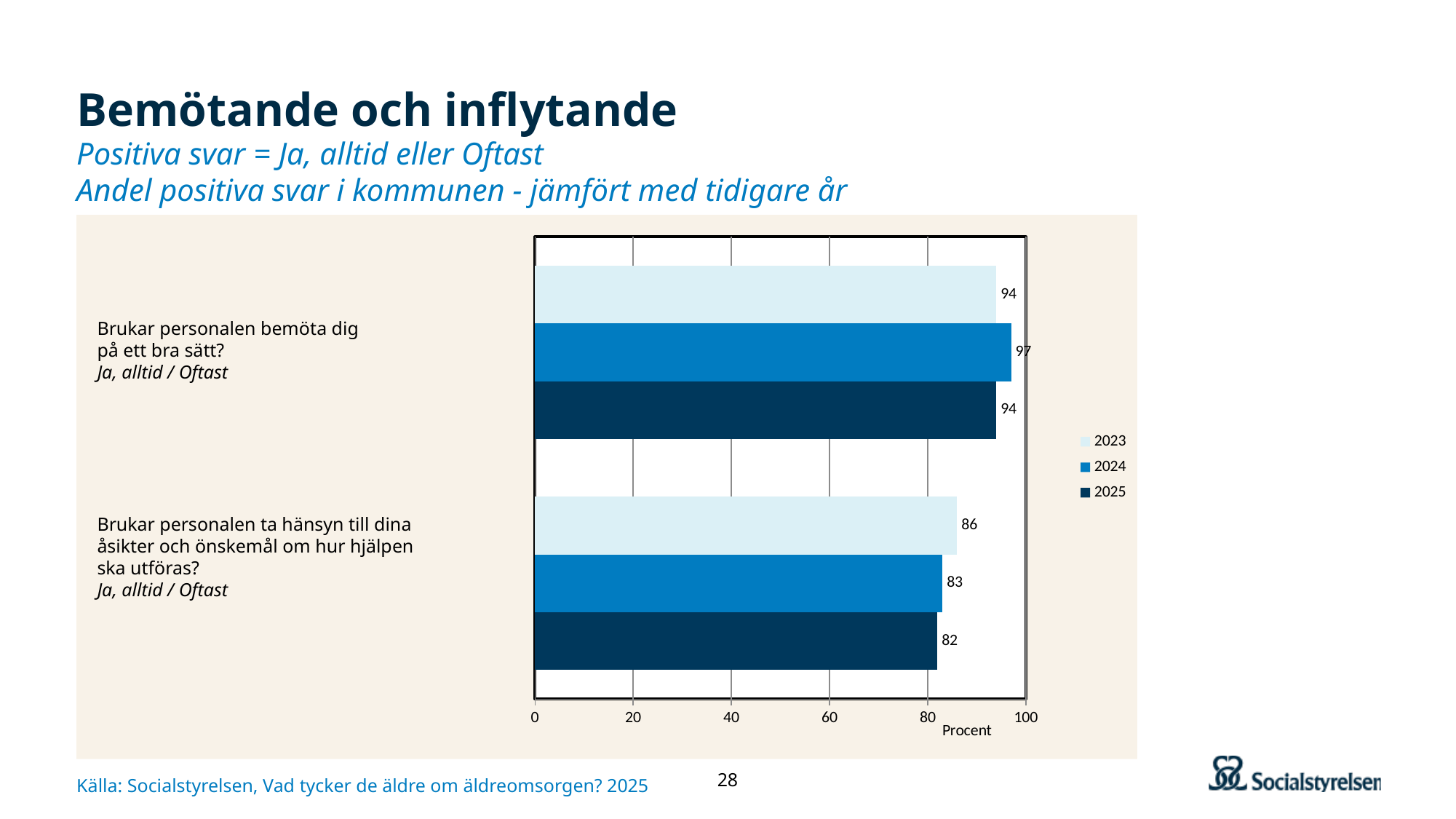
What is the label of the x axis? Procent Which year has the highest value for "Brukar personalen bemöta dig på ett bra sätt?" 2024 What is the difference between the 2024 and 2025 values for "Brukar personalen bemöta dig på ett bra sätt?" 3 What is the 2024 value for "Brukar personalen bemöta dig på ett bra sätt?" 97 What kind of chart is shown on the slide? Bar chart What is the difference between the 2023 and 2025 values for "Brukar personalen ta hänsyn till dina åsikter och önskemål om hur hjälpen ska utföras?" 4 Which is larger: the 2025 value for "Brukar personalen bemöta dig på ett bra sätt?" or the 2025 value for "Brukar personalen ta hänsyn till dina åsikter och önskemål om hur hjälpen ska utföras?" Brukar personalen bemöta dig på ett bra sätt? What is the 2023 value for "Brukar personalen ta hänsyn till dina åsikter och önskemål om hur hjälpen ska utföras?" 86 How many questions (categories) are shown in the chart? 2 Which year has the lowest value for "Brukar personalen ta hänsyn till dina åsikter och önskemål om hur hjälpen ska utföras?" 2025 How many series does the legend list? 3 What is the 2025 value for "Brukar personalen ta hänsyn till dina åsikter och önskemål om hur hjälpen ska utföras?" 82